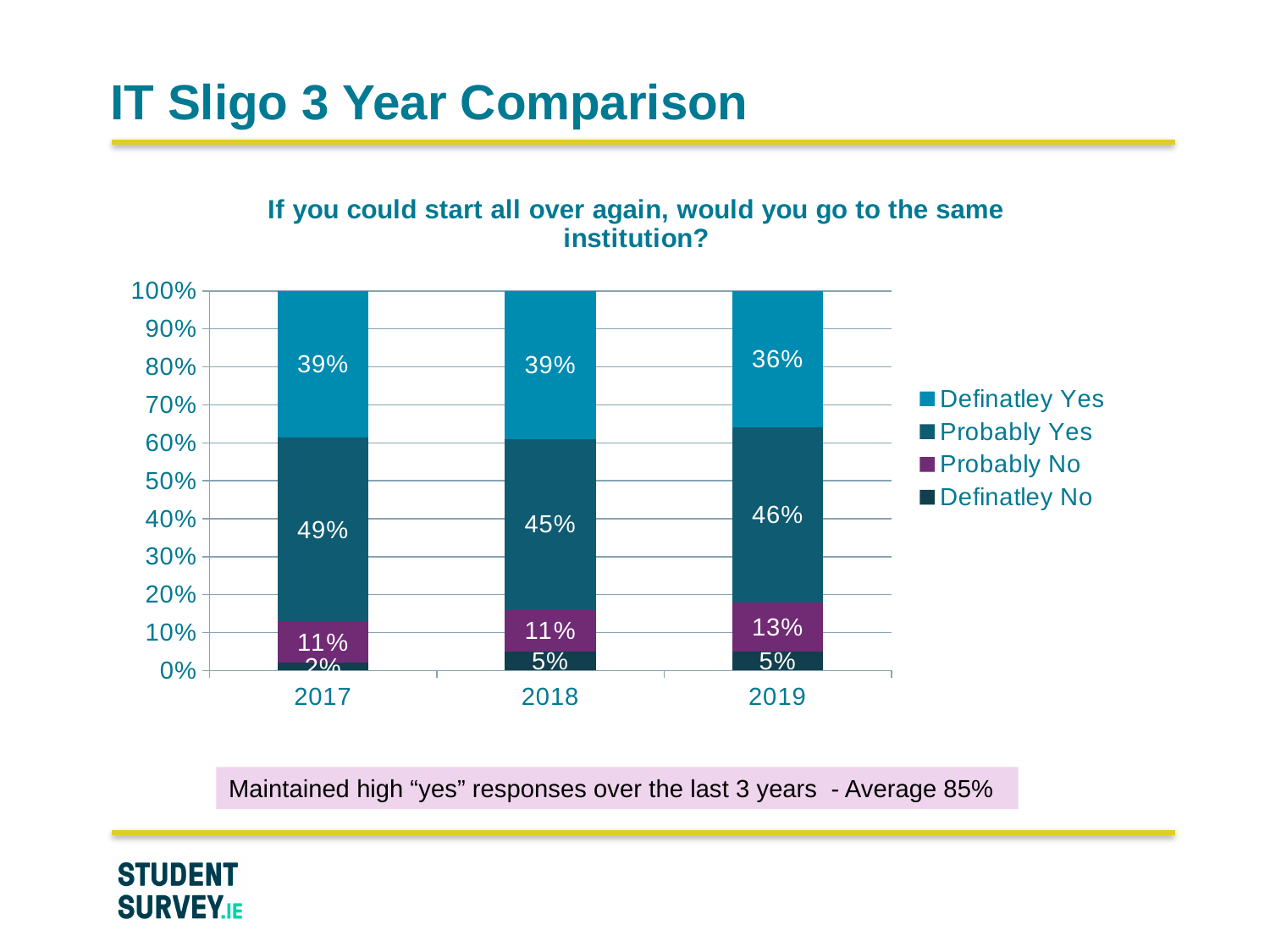
What is the title of the chart? If you could start all over again, would you go to the same institution? Which year has the larger Probably No value, 2018 or 2019? 2019 What is the value for Definatley Yes in 2019? 36% What is the difference between the Probably Yes values for 2017 and 2018? 4 percentage points What is the value for Probably Yes in 2017? 49% How many series does the legend list? 4 What is the value for Probably No in 2019? 13% What kind of chart is shown on the slide? Stacked bar chart In which year is the Probably Yes share highest? 2017 What is the value for Definatley No in 2018? 5% How many years are shown on the x axis? 3 In which year is the Definatley Yes share lowest? 2019